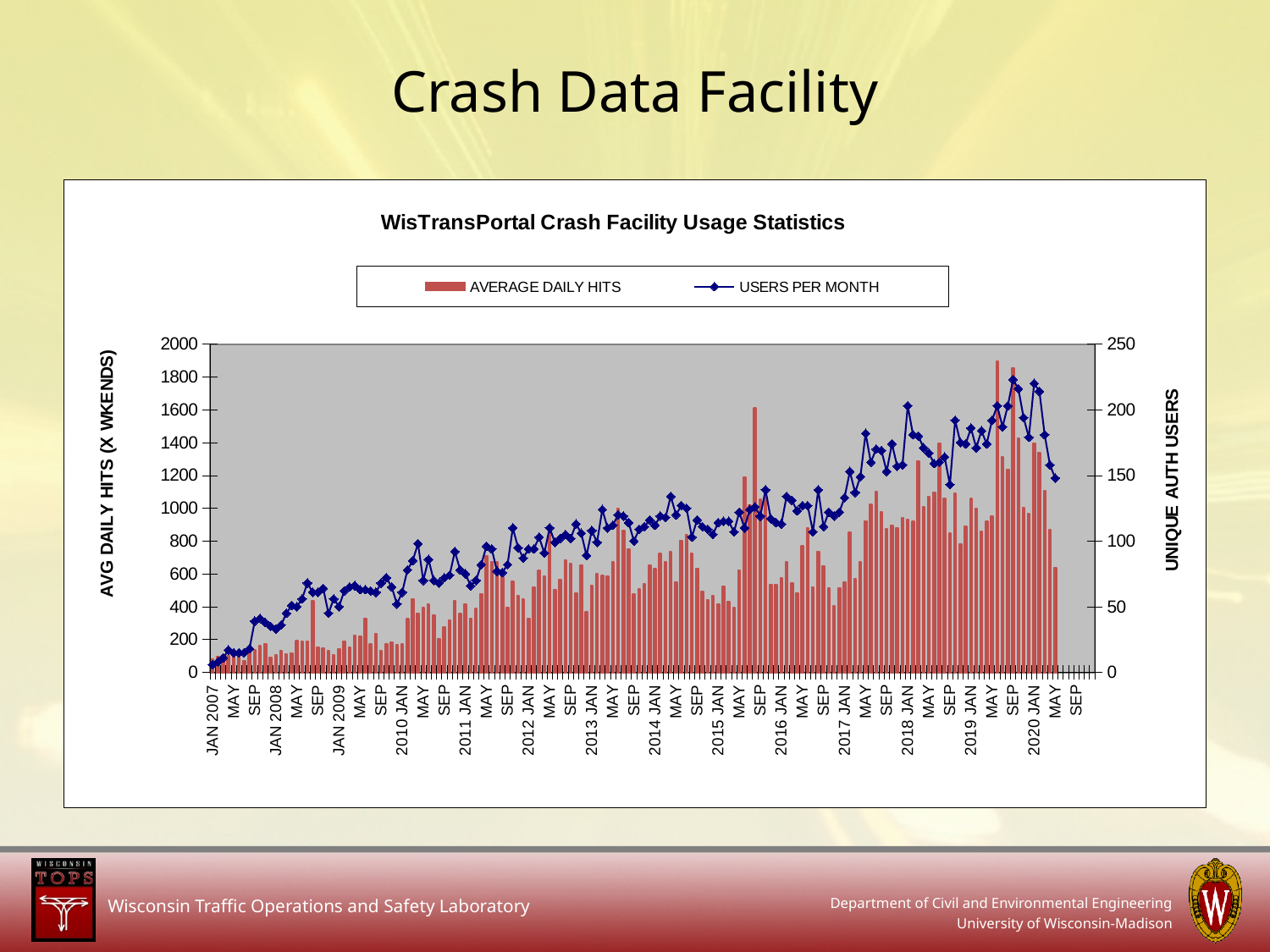
Which series is drawn as bars? AVERAGE DAILY HITS Is the highest USERS PER MONTH value greater or less than 200? greater Which is larger, the USERS PER MONTH value at JAN 2019 or at JAN 2007? JAN 2019 What is the maximum value shown on the left vertical axis? 2000 Is the tallest AVERAGE DAILY HITS bar greater or less than 1600? greater What is the title of the chart? WisTransPortal Crash Facility Usage Statistics How many series does the chart legend list? 2 Is the AVERAGE DAILY HITS value at JAN 2007 greater or less than 200? less What is the maximum value shown on the right vertical axis? 250 Overall, do the USERS PER MONTH values rise or fall from JAN 2007 to 2020? Rise What kind of chart is shown on the slide? Combined bar and line chart